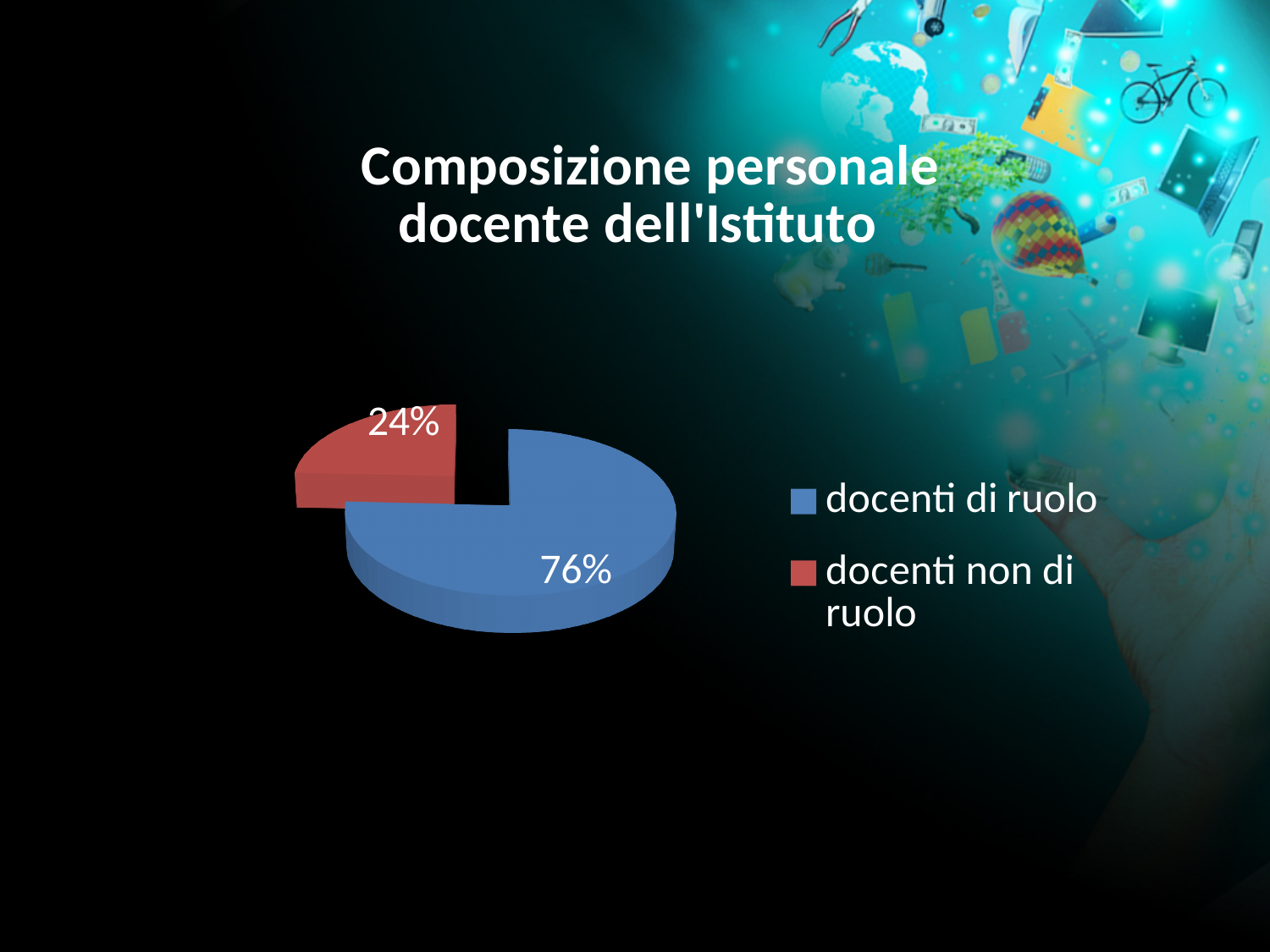
What kind of chart is shown on the slide? pie chart What share of the pie is 'docenti di ruolo'? 76% What colour is the slice for 'docenti non di ruolo'? red How many entries does the legend list? 2 Which category has the largest slice of the pie? docenti di ruolo What is the difference in percentage points between 'docenti di ruolo' and 'docenti non di ruolo'? 52 Which category has the smallest slice of the pie? docenti non di ruolo What is the title of the chart? Composizione personale docente dell'Istituto Which is larger, the share for 'docenti di ruolo' or for 'docenti non di ruolo'? docenti di ruolo What share of the pie is 'docenti non di ruolo'? 24% How many slices does the pie chart have? 2